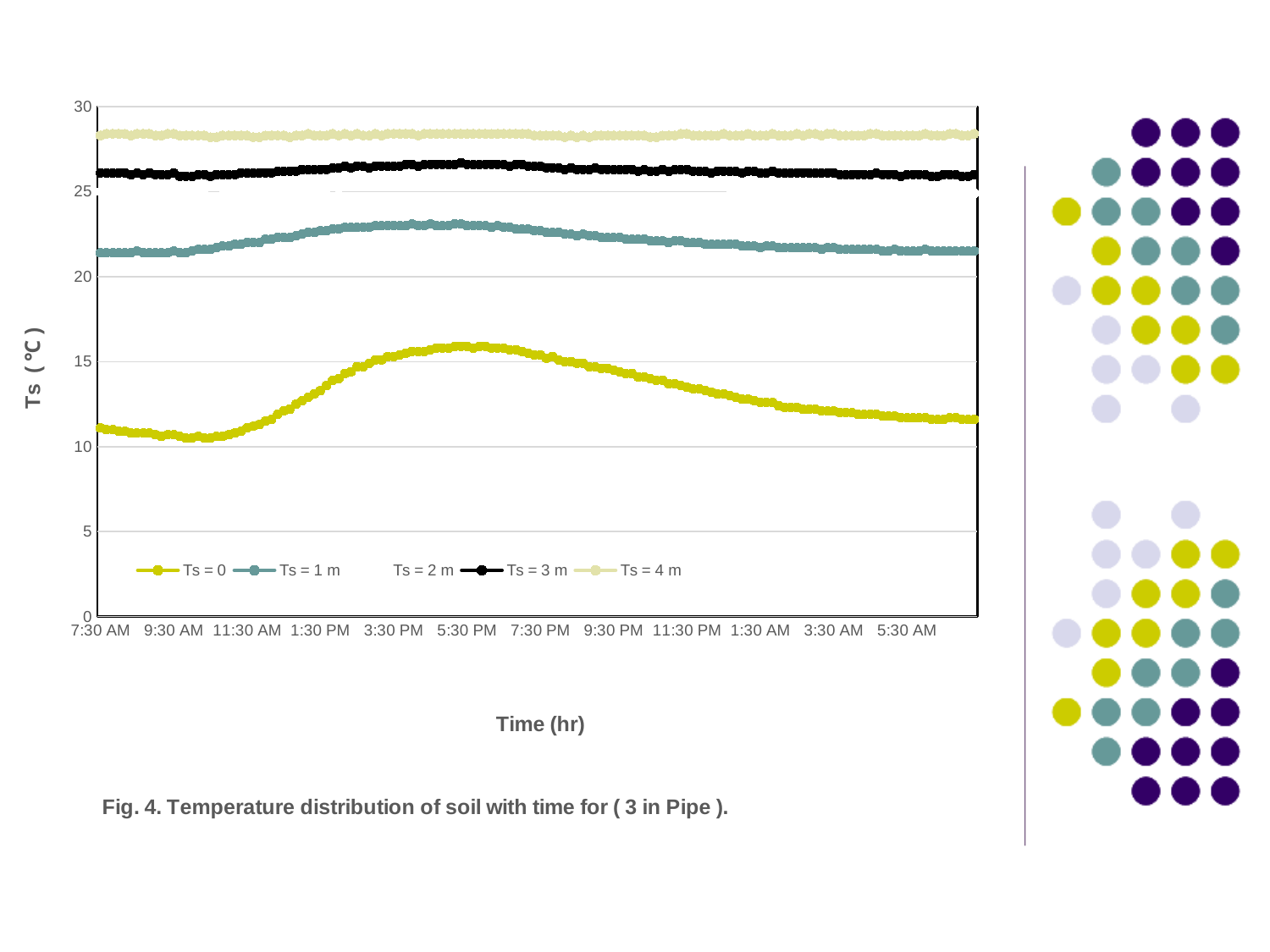
Does the Ts = 0 series rise or fall between 9:30 AM and 5:30 PM? rise Is the value for Ts = 4 m at 7:30 AM greater or less than 25? greater Which series has the lowest temperature values throughout the chart? Ts = 0 At 5:30 PM, which series has the larger value, Ts = 3 m or Ts = 1 m? Ts = 3 m Is the value for Ts = 1 m at 5:30 PM greater or less than 25? less What kind of chart is shown on the slide? line chart Is the value for Ts = 0 at 7:30 AM greater or less than 10? greater How many series does the legend list? 5 Which series has the highest temperature values throughout the chart? Ts = 4 m What is the title of the y axis? Ts (°C) How many time labels are shown on the x axis? 12